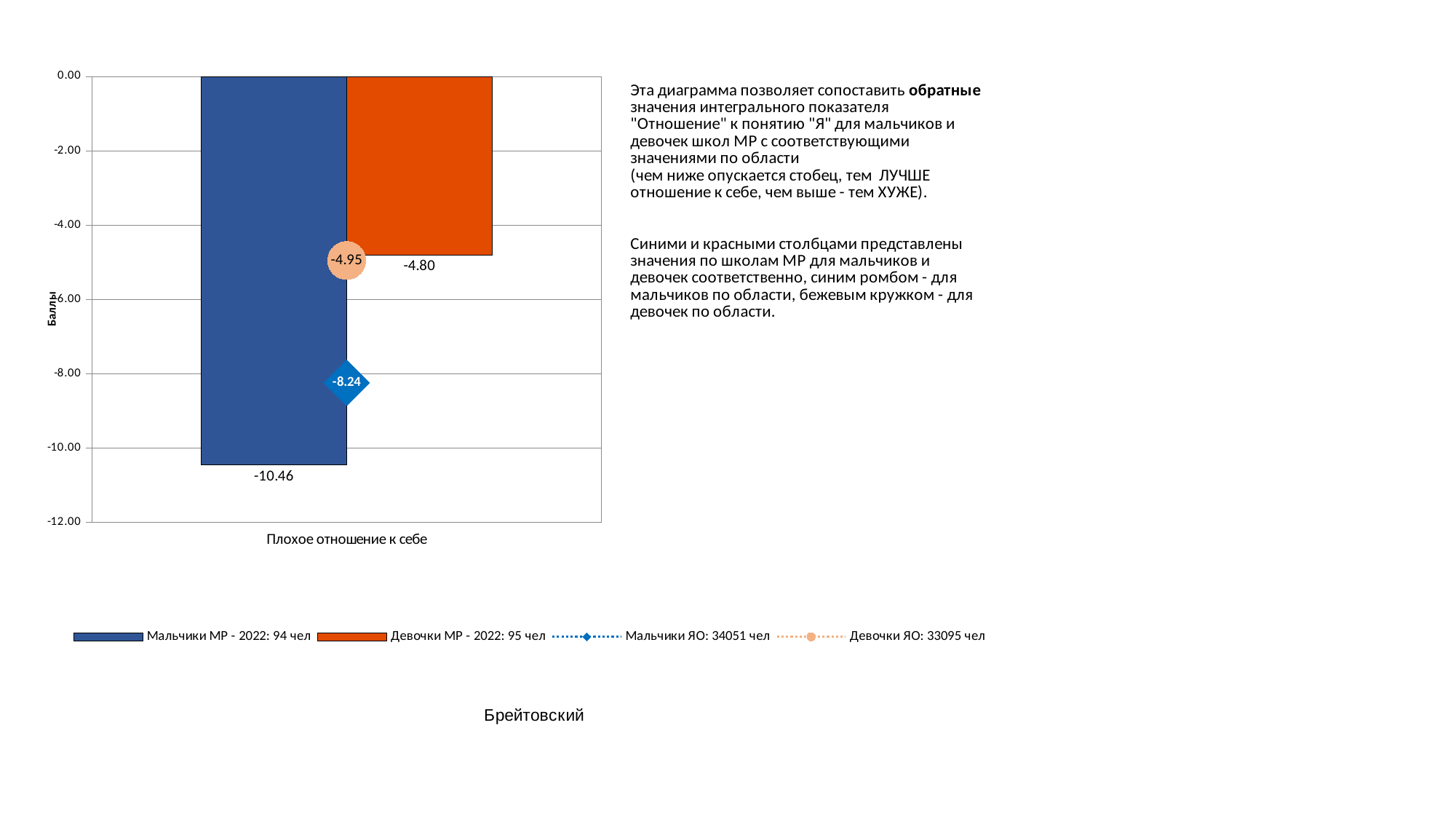
What is the difference between the Мальчики МР - 2022 bar (-10.46) and the Мальчики ЯО marker (-8.24)? 2.22 What is the value of the bar for Мальчики МР - 2022: 94 чел? -10.46 Which series has the lowest (most negative) value on the chart? Мальчики МР - 2022: 94 чел Which is lower: the Девочки МР - 2022 bar or the Девочки ЯО marker? Девочки ЯО marker What value is shown by the blue diamond marker for Мальчики ЯО: 34051 чел? -8.24 What is the value of the bar for Девочки МР - 2022: 95 чел? -4.80 What type of chart is this? Bar chart What value is shown by the beige circle marker for Девочки ЯО: 33095 чел? -4.95 What is the label of the y axis? Баллы Which series has the highest (least negative) value on the chart? Девочки МР - 2022: 95 чел How many categories are shown on the x axis? 1 How many series does the legend list? 4